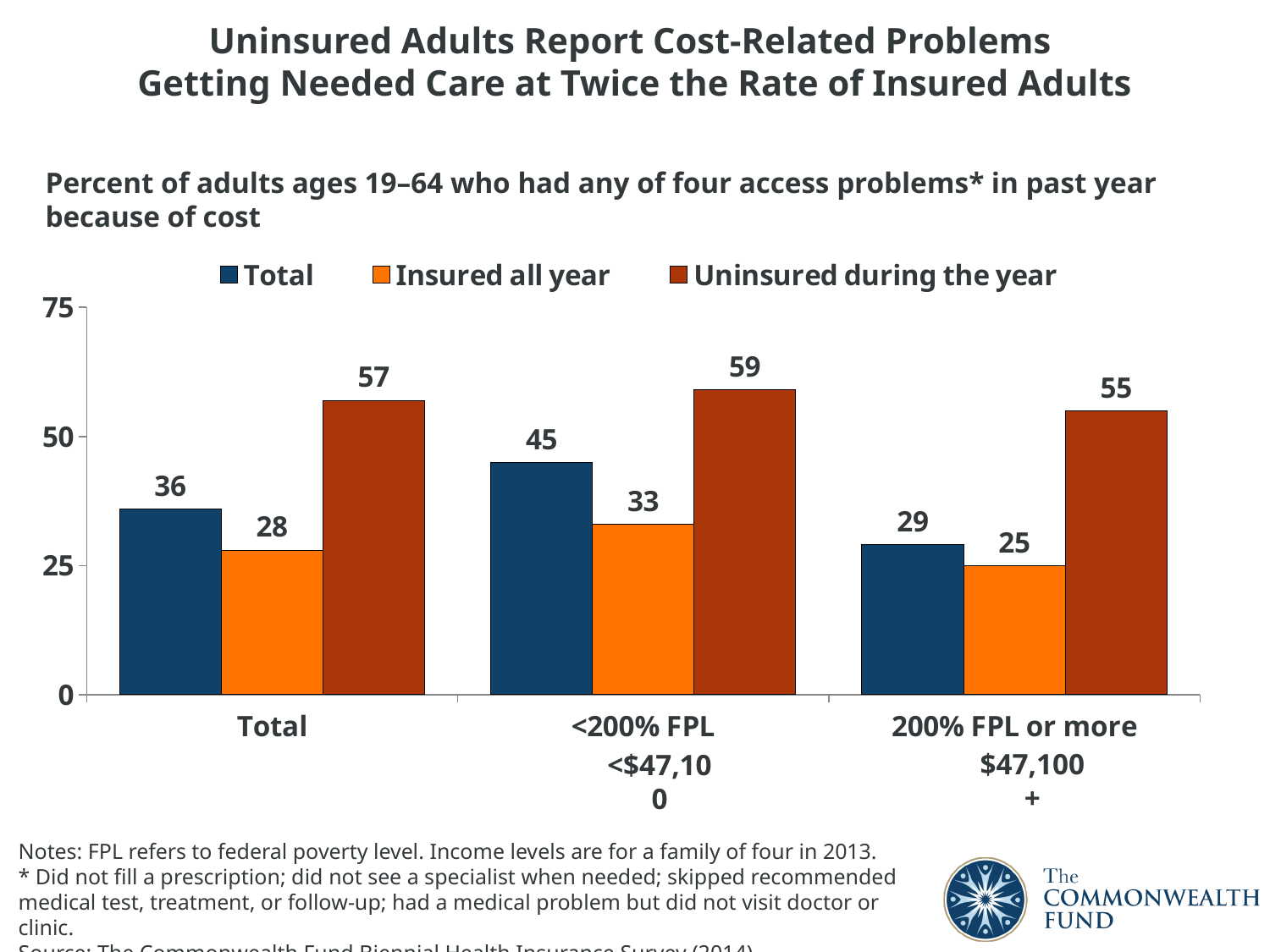
What is the difference between "Uninsured during the year" and "Insured all year" in the Total category? 29 What is the value for "Insured all year" in the <200% FPL category? 33 Which is larger: "Insured all year" for <200% FPL or "Total" for 200% FPL or more? Insured all year for <200% FPL Which category has the highest value for "Uninsured during the year"? <200% FPL How many series does the legend list? 3 What is the value for "Uninsured during the year" in the Total category? 57 Which series is shown in orange? Insured all year How many categories are shown on the x axis? 3 What kind of chart is shown on the slide? Bar chart What is the difference between the "Total" values for <200% FPL and 200% FPL or more? 16 Which category has the lowest value for "Insured all year"? 200% FPL or more What is the value for "Total" in the 200% FPL or more category? 29